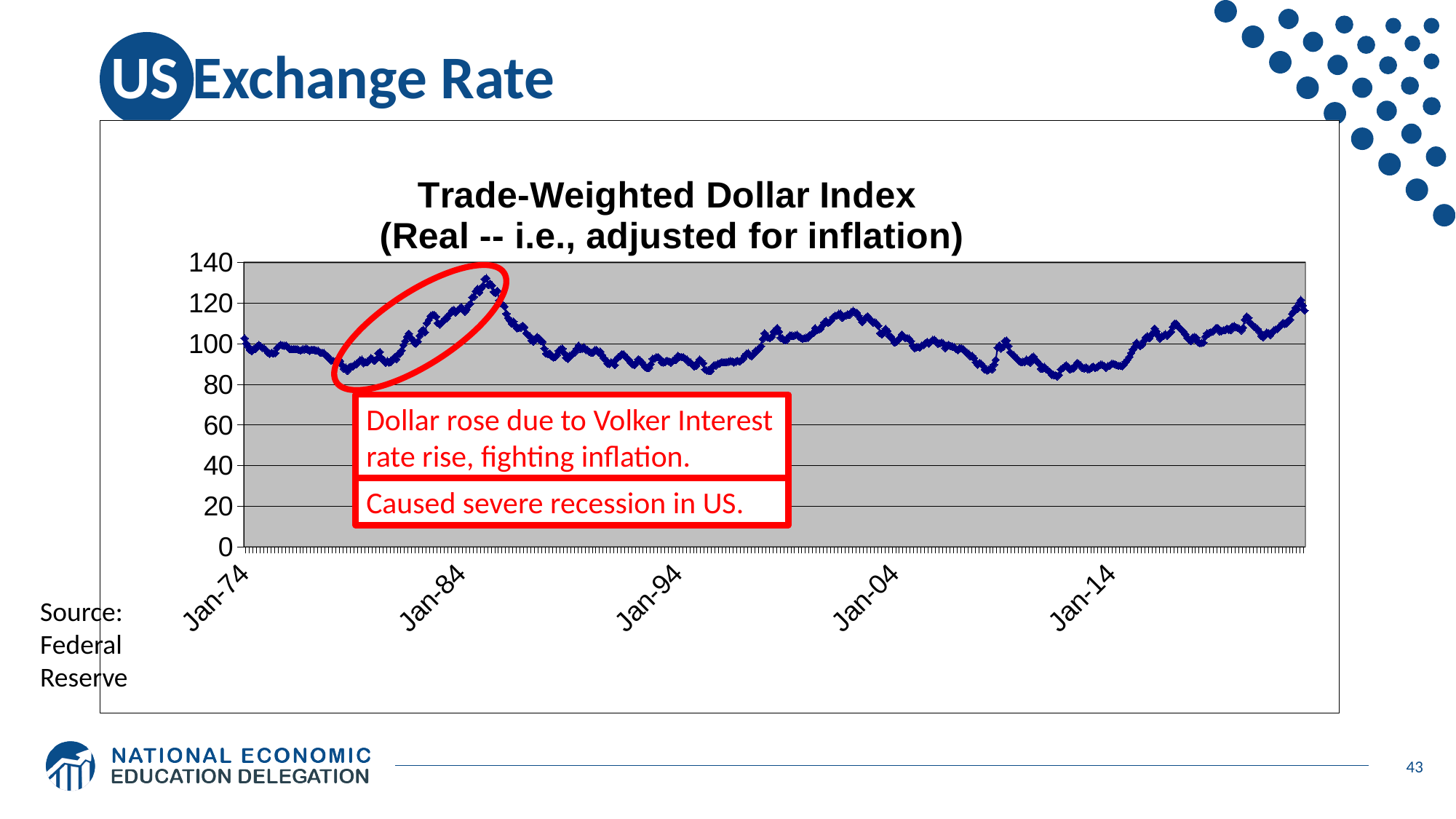
Does the Trade-Weighted Dollar Index rise or fall between Jan-04 and Jan-14? fall What kind of chart is shown on the slide? line chart Does the Trade-Weighted Dollar Index rise or fall from its mid-1980s peak to Jan-94? fall What is the title of the chart? Trade-Weighted Dollar Index (Real -- i.e., adjusted for inflation) Does the Trade-Weighted Dollar Index ever fall below 80 on the chart? No Does the Trade-Weighted Dollar Index ever rise above 140 on the chart? No What is the highest value shown on the y axis of the chart? 140 In which decade does the Trade-Weighted Dollar Index reach its highest point on the chart? 1980s Is the value of the Trade-Weighted Dollar Index at Jan-94 greater or less than 100? less How many date labels are shown on the x axis of the chart? 5